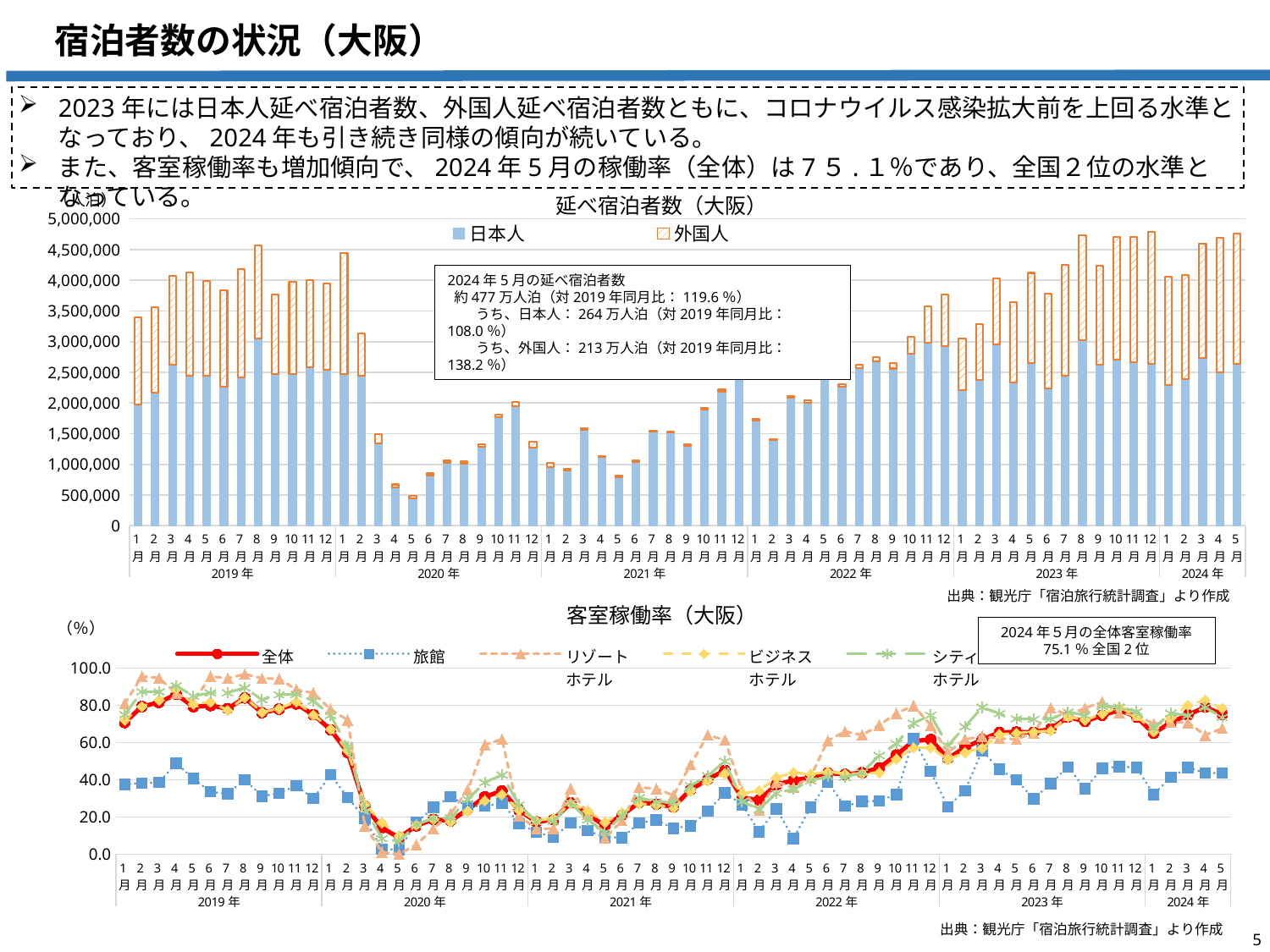
What kind of chart is the bottom chart titled 客室稼働率（大阪）? line chart What kind of chart is the top chart titled 延べ宿泊者数（大阪）? bar chart In the top chart 延べ宿泊者数（大阪）, how many series does the legend list? 2 In the bottom chart 客室稼働率（大阪）, does the 全体 line rise or fall from 2020年1月 to 2020年5月? fall In the bottom chart 客室稼働率（大阪）, how many series does the legend list? 5 In the top chart 延べ宿泊者数（大阪）, is the total for 2021年5月 greater or less than 1,000,000? less In the bottom chart 客室稼働率（大阪）, what is the 全体 occupancy rate for 2024年5月 as stated on the slide? 75.1% In the top chart 延べ宿泊者数（大阪）, which month has the lowest total bar? 2020年5月 In the bottom chart 客室稼働率（大阪）, is the 旅館 value for 2020年5月 greater or less than 20.0? less In the bottom chart 客室稼働率（大阪）, which is larger in 2019年1月, the 全体 value or the 旅館 value? 全体 In the bottom chart 客室稼働率（大阪）, in which month does the 全体 line reach its lowest point? 2020年5月 In the top chart 延べ宿泊者数（大阪）, is the total for 2019年8月 greater or less than 4,000,000? greater